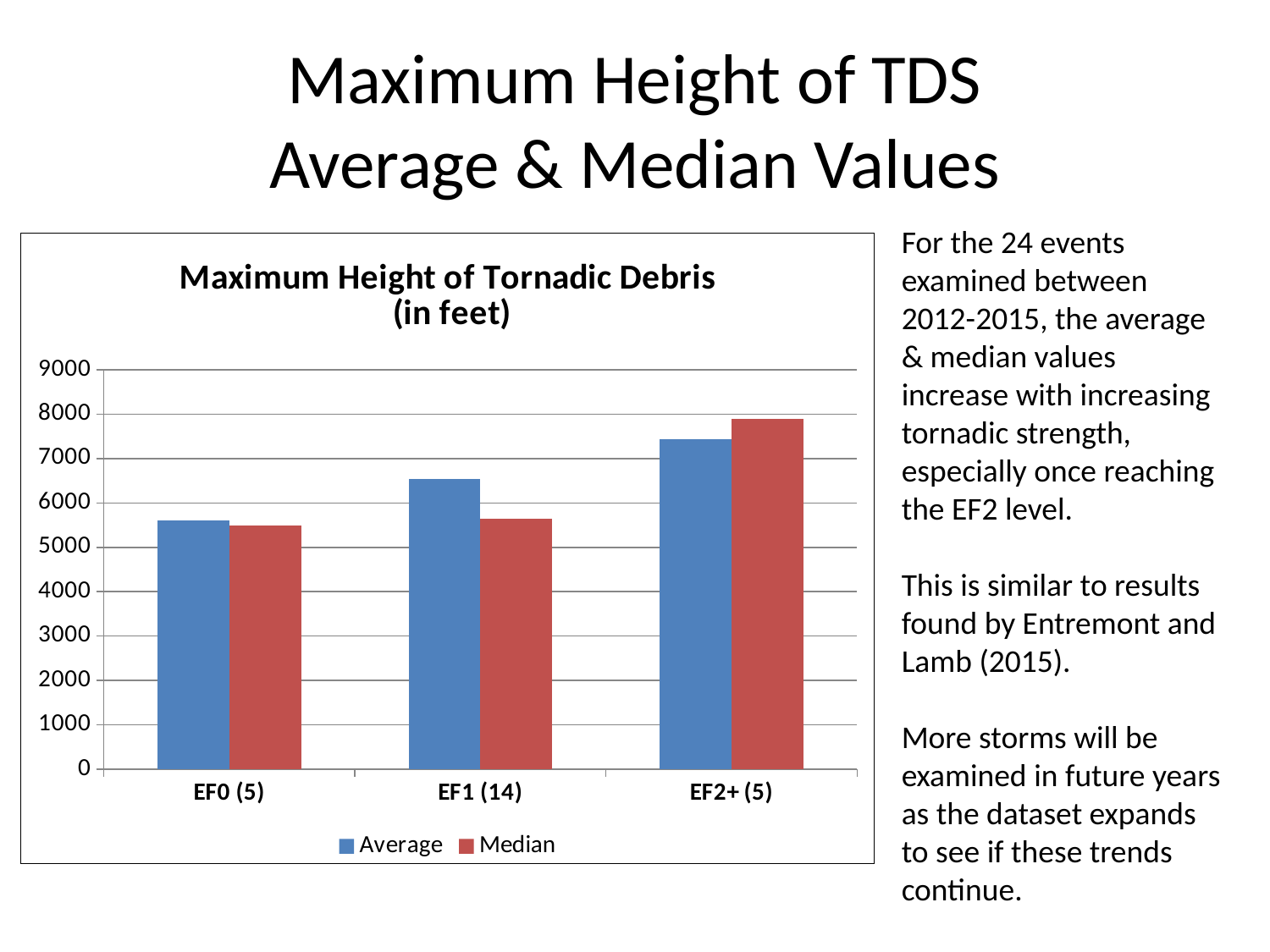
What is the title of the chart? Maximum Height of Tornadic Debris (in feet) Is the Average value for EF1 (14) greater or less than 7000? less What kind of chart is shown on the slide? bar chart Is the Median value for EF1 (14) greater or less than 6000? less Which category has the highest Average value? EF2+ (5) Which category has the lowest Median value? EF0 (5) How many categories are shown on the x axis of the chart? 3 For EF1 (14), which is larger, the Average or the Median? Average How many series does the chart's legend list? 2 Do the Average values rise or fall from EF0 (5) to EF2+ (5)? rise Is the Median value for EF2+ (5) greater or less than 7000? greater For EF2+ (5), which is larger, the Average or the Median? Median